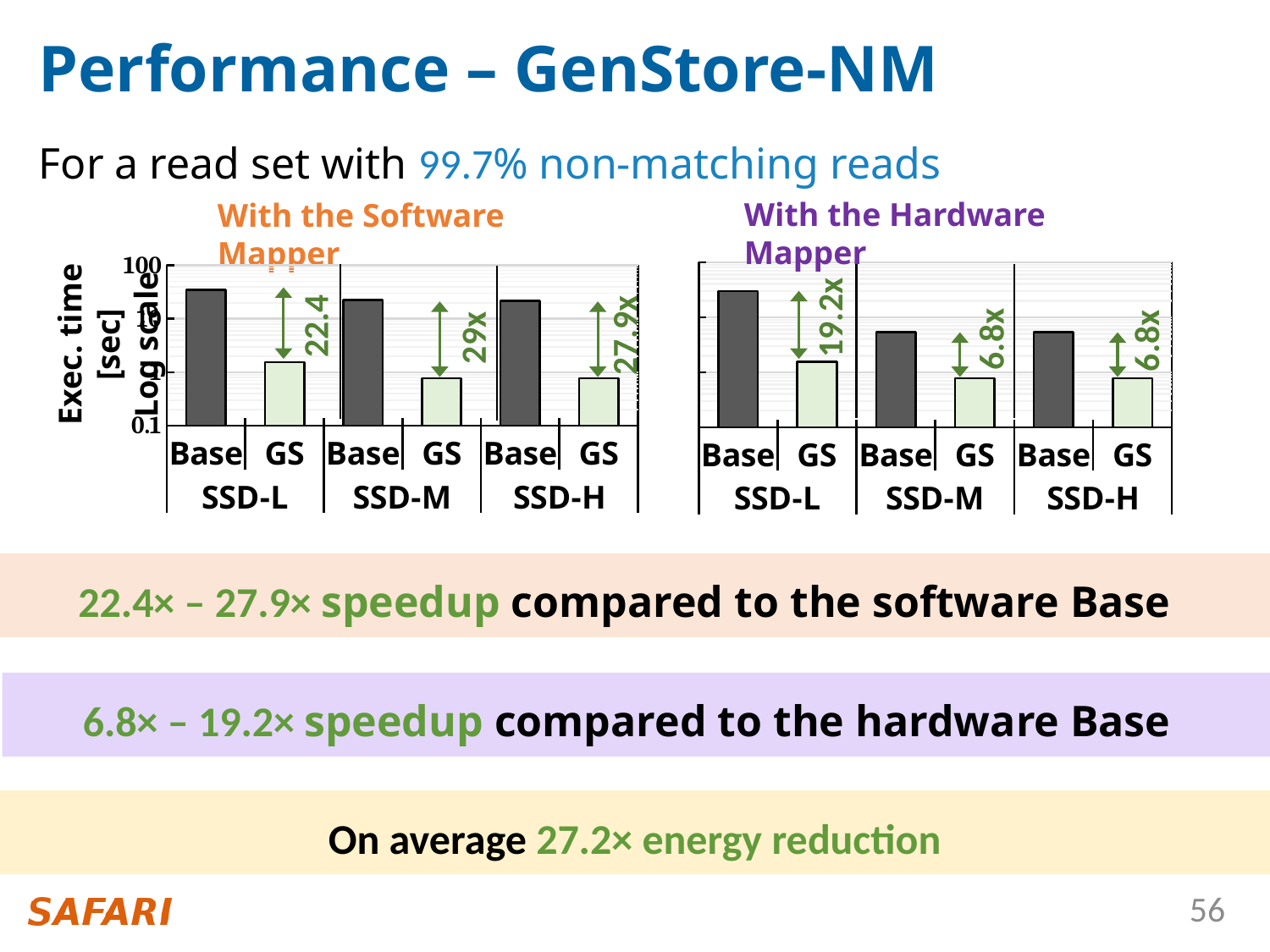
What is the y-axis label of the 'With the Software Mapper' chart? Exec. time [sec] Log scale In the 'With the Software Mapper' chart, which bar is taller for SSD-L, Base or GS? Base In the 'With the Software Mapper' chart, which SSD configuration has the largest annotated speedup? SSD-M In the 'With the Hardware Mapper' chart, what speedup is annotated for SSD-L? 19.2x In the 'With the Software Mapper' chart, what speedup is annotated for SSD-H? 27.9x In the 'With the Hardware Mapper' chart, what speedup is annotated for SSD-M? 6.8x In the 'With the Software Mapper' chart, is the execution time of Base for SSD-L greater or less than 10? greater Which three SSD configurations are shown along the x axis of each chart? SSD-L, SSD-M, SSD-H In the 'With the Software Mapper' chart, how many bars are plotted? 6 In the 'With the Hardware Mapper' chart, which SSD configuration has the largest annotated speedup? SSD-L What kind of chart is used in the 'With the Software Mapper' panel? bar chart In the 'With the Software Mapper' chart, what speedup is annotated for SSD-M? 29x